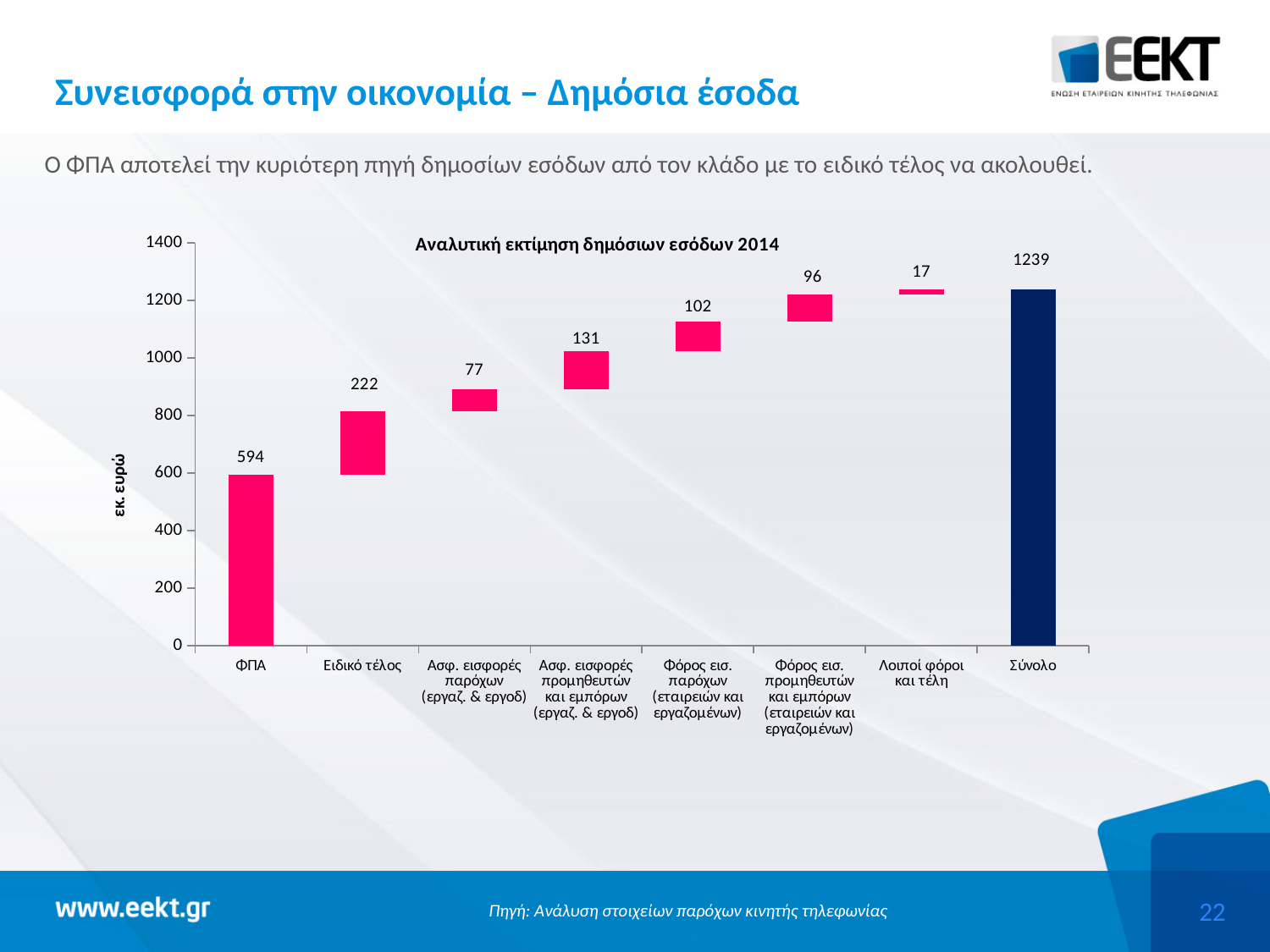
What is the difference between the values for ΦΠΑ and Ειδικό τέλος? 372 What is the value shown for Σύνολο? 1239 What kind of chart is shown on the slide? bar chart Which is larger: Ασφ. εισφορές προμηθευτών και εμπόρων (131) or Φόρος εισ. παρόχων (102)? Ασφ. εισφορές προμηθευτών και εμπόρων What is the value for ΦΠΑ in the chart? 594 What is the title of the chart? Αναλυτική εκτίμηση δημόσιων εσόδων 2014 Excluding the Σύνολο bar, which category has the highest value? ΦΠΑ What is the value for Ειδικό τέλος? 222 How many categories are shown on the x axis of the chart? 8 Which category has the lowest value? Λοιποί φόροι και τέλη Is the value for ΦΠΑ greater or less than 400? greater What is the value for Λοιποί φόροι και τέλη? 17